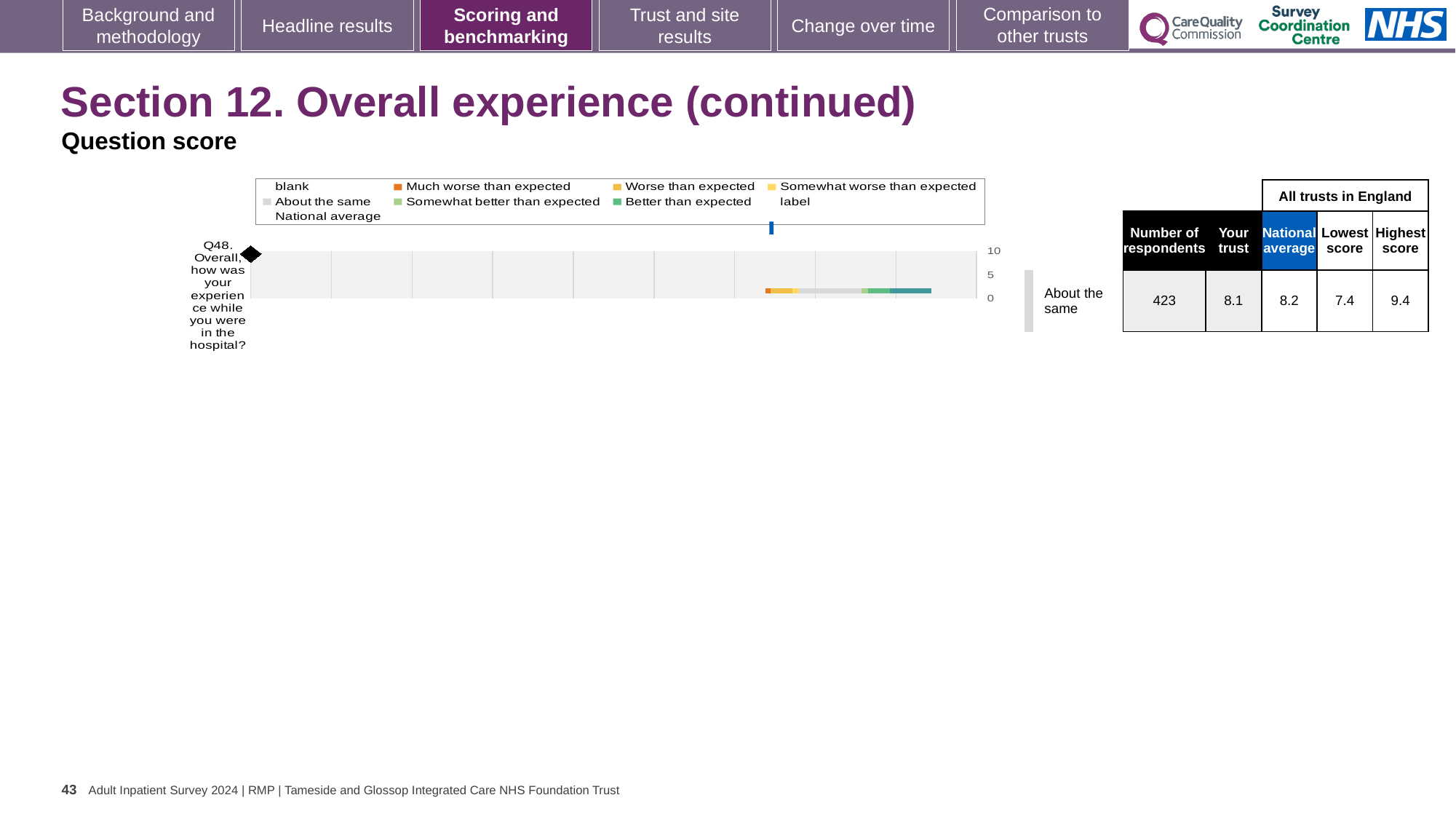
Which is larger for Q48, the 'Your trust' score or the national average? National average Which question is plotted on the chart? Q48. Overall, how was your experience while you were in the hospital? What benchmarking category is the trust's Q48 score placed in? About the same What is the highest tick value shown on the chart's axis? 10 What is the difference between the highest score and the lowest score for Q48 in the table? 2.0 What kind of chart is shown on the slide? bar chart According to the table, what is the highest score among all trusts in England for Q48? 9.4 According to the table, what is the 'Your trust' score for Q48? 8.1 According to the table, what is the national average score for Q48? 8.2 According to the table, what is the lowest score among all trusts in England for Q48? 7.4 How many questions (categories) are plotted on the chart? 1 According to the table, what is the number of respondents for Q48? 423